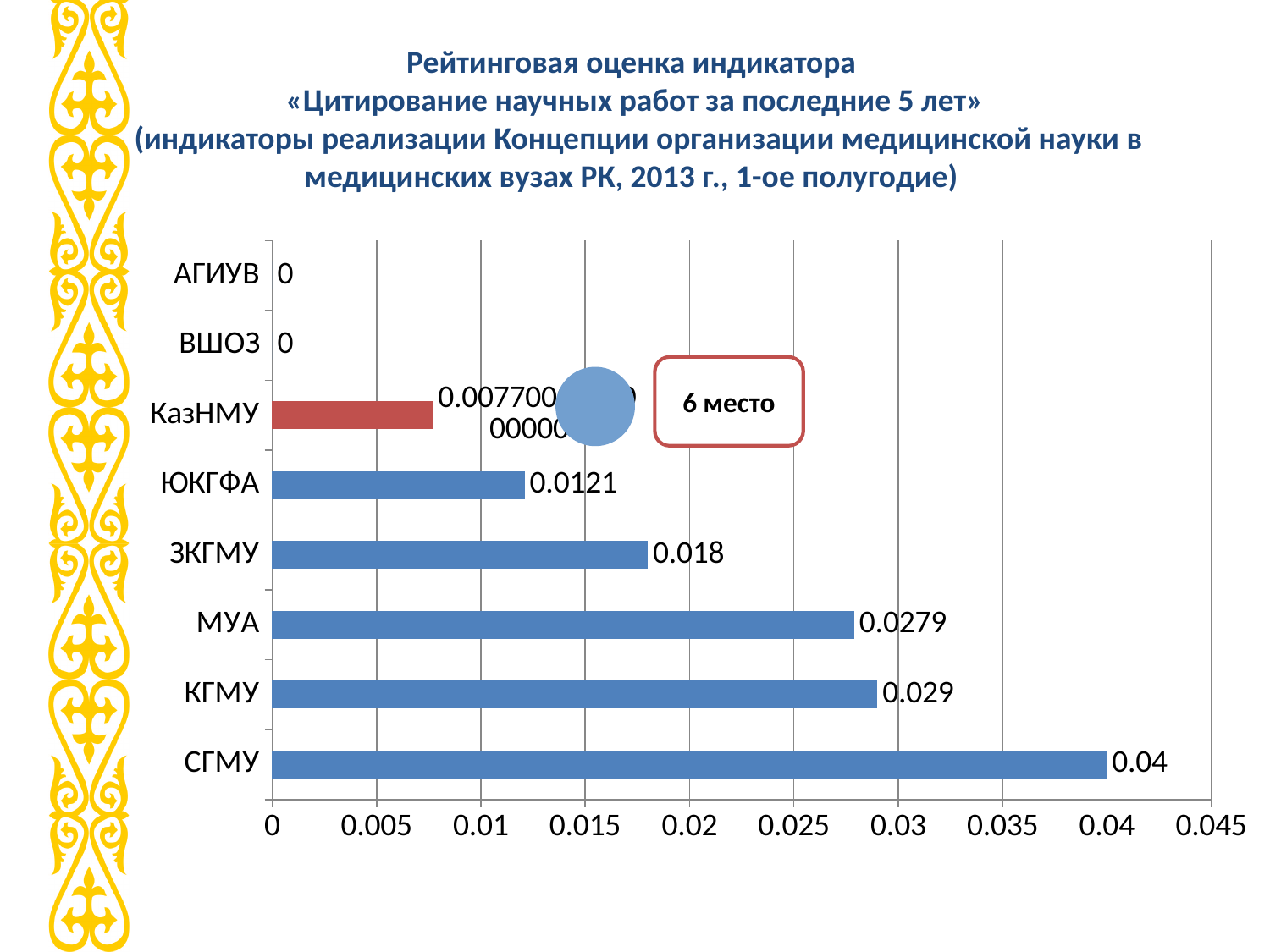
What is the value for ЮКГФА? 0.0121 What kind of chart is shown on the slide? bar chart Which category has the highest value? СГМУ What is the value for ЗКГМУ? 0.018 What is the difference between the values for СГМУ and КГМУ? 0.011 Which category's bar is coloured red instead of blue? КазНМУ How many categories are shown on the chart? 8 What is the value for КГМУ? 0.029 What is the value for МУА? 0.0279 Is the value for КазНМУ greater or less than 0.01? less What is the value for СГМУ? 0.04 Which is larger, the value for КГМУ or the value for МУА? КГМУ